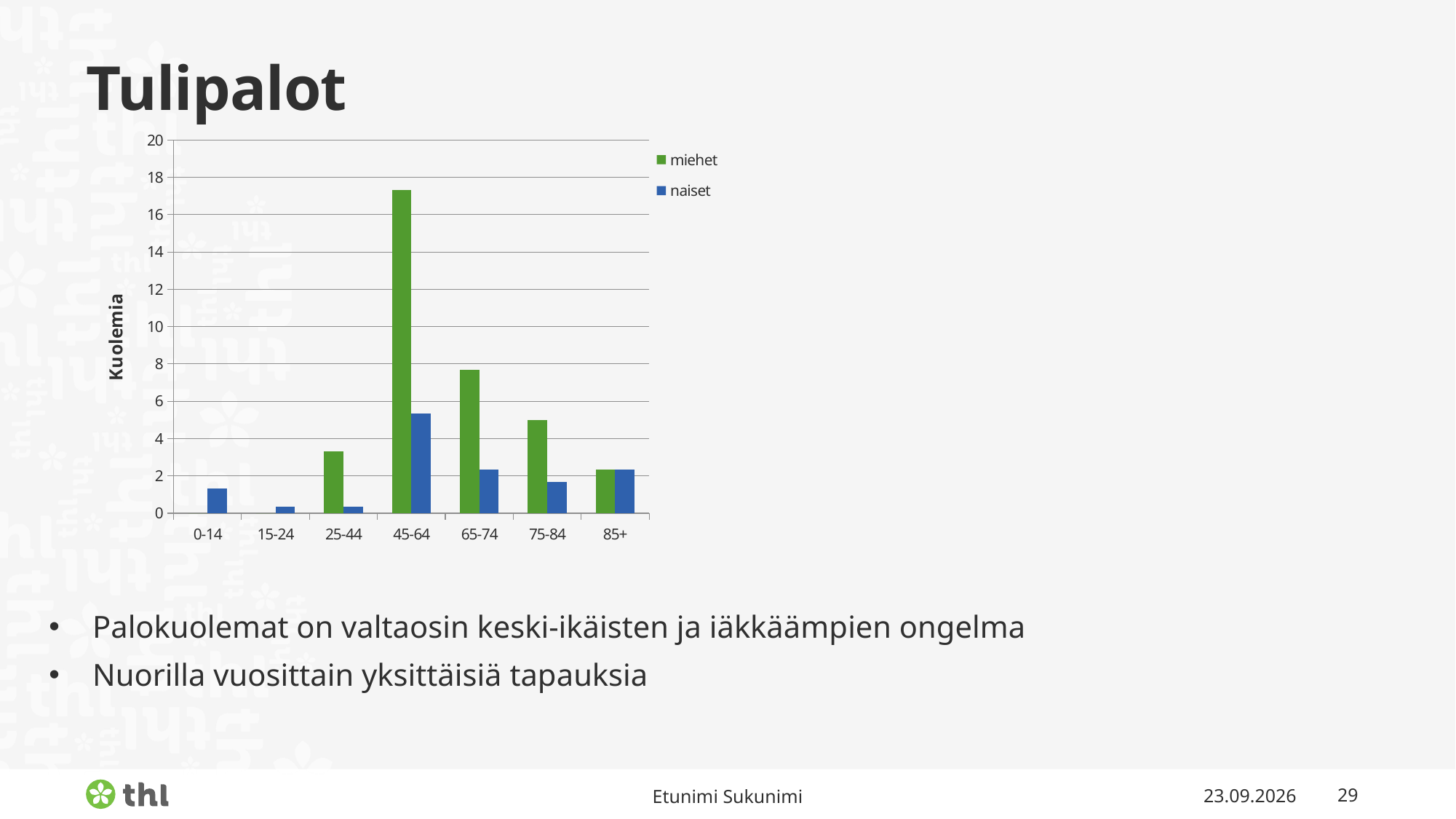
How many age-group categories are shown on the x axis? 7 In the 65-74 group, which series has the larger value, miehet or naiset? miehet Which age group has the highest value for naiset? 45-64 Is the value for miehet in the 45-64 group greater or less than 16? greater How many series does the legend list? 2 Is the value for naiset in the 45-64 group greater or less than 6? less What is the title of the y axis? Kuolemia Is the value for miehet in the 65-74 group greater or less than 6? greater In the 25-44 group, which series has the larger value, miehet or naiset? miehet From the 45-64 group to the 85+ group, do the miehet values rise or fall? fall Which age group has the highest value for miehet? 45-64 What kind of chart is shown on the slide? bar chart